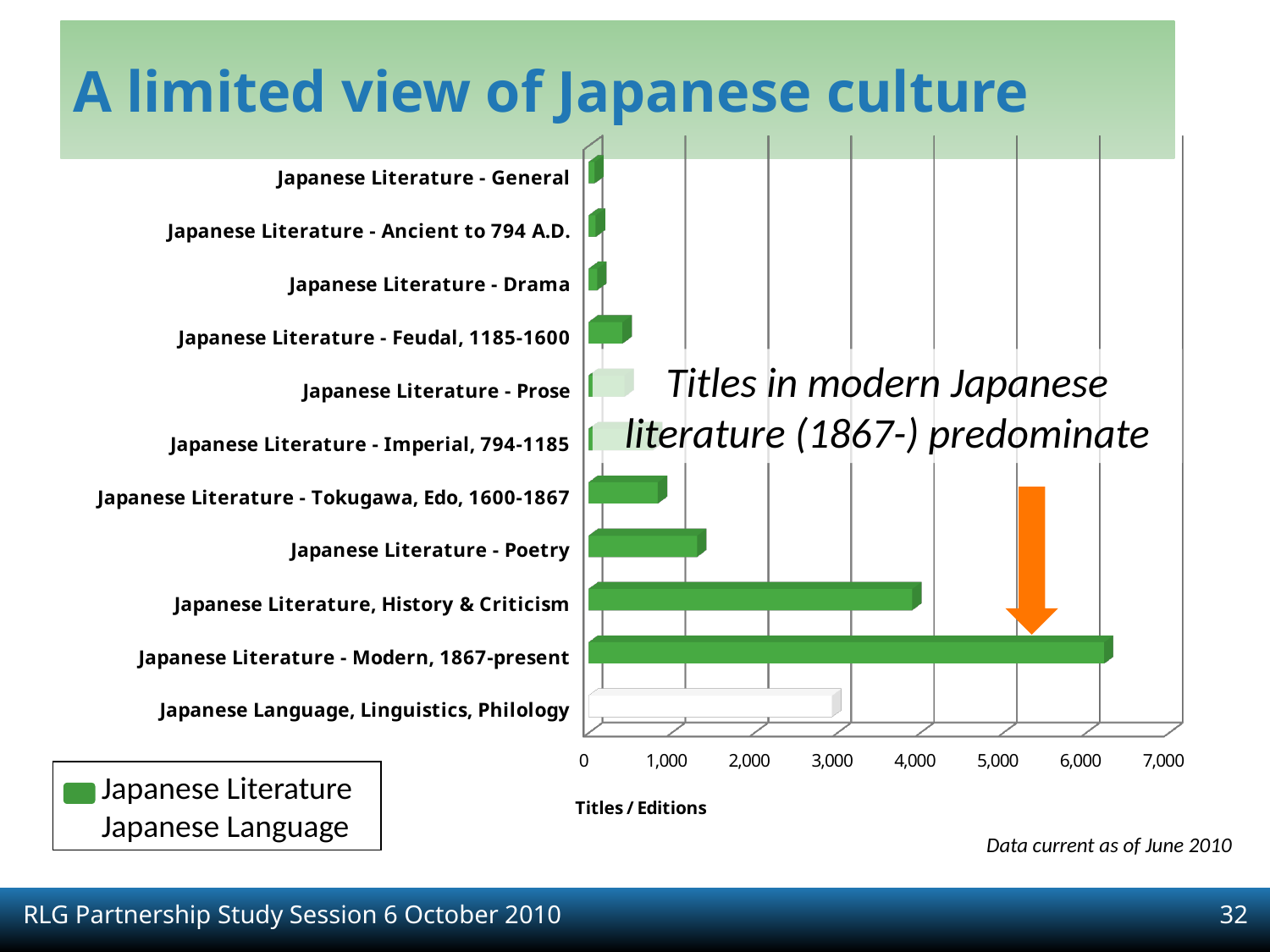
How many categories are plotted in the chart? 11 Is the value for Japanese Literature - Tokugawa, Edo, 1600-1867 greater or less than 1,000? less Is the value for Japanese Literature - Poetry greater or less than 2,000? less Which is larger: the value for Japanese Literature - Modern, 1867-present or for Japanese Literature, History & Criticism? Japanese Literature - Modern, 1867-present Which is larger: the value for Japanese Literature - Poetry or for Japanese Literature - Tokugawa, Edo, 1600-1867? Japanese Literature - Poetry How many series does the legend list? 2 What kind of chart is shown on the slide? bar chart Is the value for Japanese Literature, History & Criticism greater or less than 3,000? greater What is the label on the horizontal axis of the chart? Titles / Editions Which category has the highest value in the chart? Japanese Literature - Modern, 1867-present